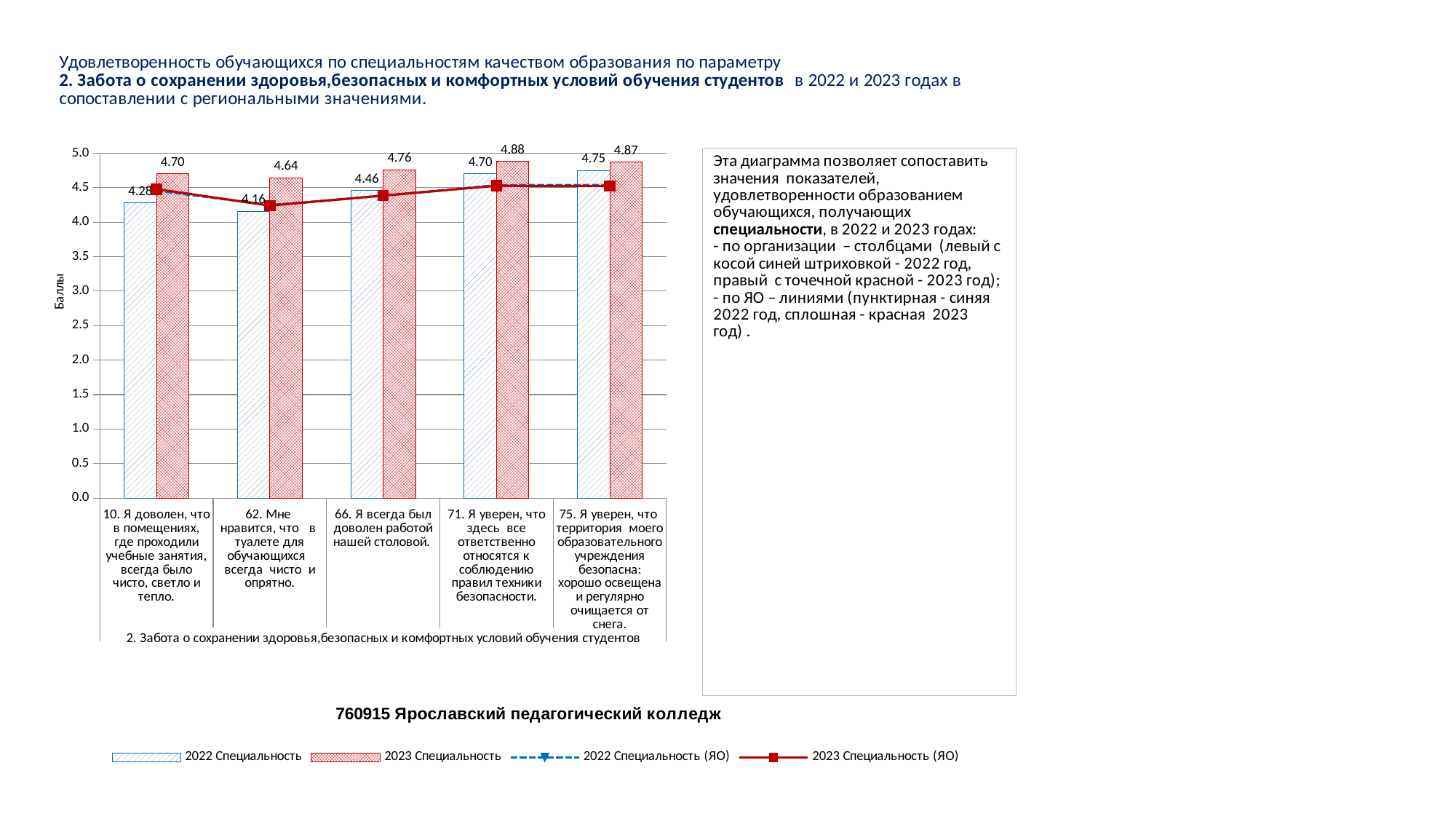
Is the 2023 Специальность (ЯО) line value for category "62. Мне нравится, что в туалете для обучающихся всегда чисто и опрятно." greater or less than 4.0? greater What kind of chart is shown on the slide? Bar chart with line series Which category has the lowest 2022 Специальность bar? 62. Мне нравится, что в туалете для обучающихся всегда чисто и опрятно. What is the value of the 2023 Специальность bar for category "62. Мне нравится, что в туалете для обучающихся всегда чисто и опрятно."? 4.64 What is the label of the vertical axis of the chart? Баллы What is the value of the 2022 Специальность bar for category "66. Я всегда был доволен работой нашей столовой."? 4.46 How many categories are shown on the x axis of the chart? 5 How many series does the chart legend list? 4 What is the difference between the 2023 and 2022 Специальность bars for category "10. Я доволен, что в помещениях, где проходили учебные занятия, всегда было чисто, светло и тепло."? 0.42 What is the value of the 2022 Специальность bar for category "10. Я доволен, что в помещениях, где проходили учебные занятия, всегда было чисто, светло и тепло."? 4.28 Which is larger for category "75. Я уверен, что территория моего образовательного учреждения безопасна: хорошо освещена и регулярно очищается от снега.": the 2022 Специальность bar or the 2023 Специальность bar? 2023 Специальность Which category has the highest 2023 Специальность bar? 71. Я уверен, что здесь все ответственно относятся к соблюдению правил техники безопасности.